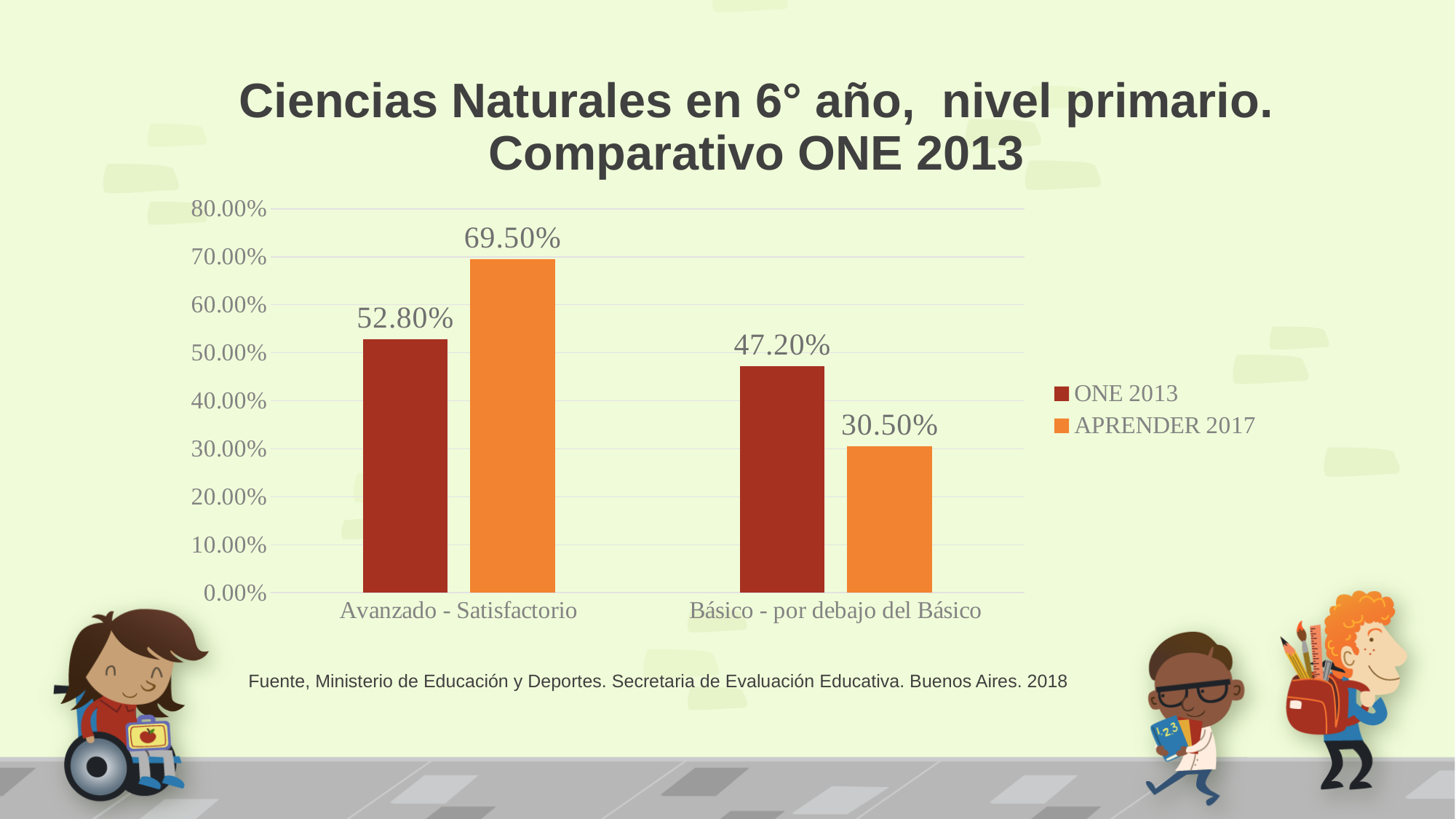
What is the difference between the ONE 2013 and APRENDER 2017 values for Básico - por debajo del Básico? 16.70% What is the ONE 2013 value for Básico - por debajo del Básico? 47.20% How many series does the legend list? 2 What is the difference between the APRENDER 2017 and ONE 2013 values for Avanzado - Satisfactorio? 16.70% What is the ONE 2013 value for Avanzado - Satisfactorio? 52.80% Which is larger for Básico - por debajo del Básico: ONE 2013 or APRENDER 2017? ONE 2013 What is the APRENDER 2017 value for Avanzado - Satisfactorio? 69.50% What kind of chart is shown on the slide? Bar chart How many categories are shown on the x axis? 2 What is the APRENDER 2017 value for Básico - por debajo del Básico? 30.50% Which bar has the highest value on the chart? APRENDER 2017, Avanzado - Satisfactorio Which bar has the lowest value on the chart? APRENDER 2017, Básico - por debajo del Básico